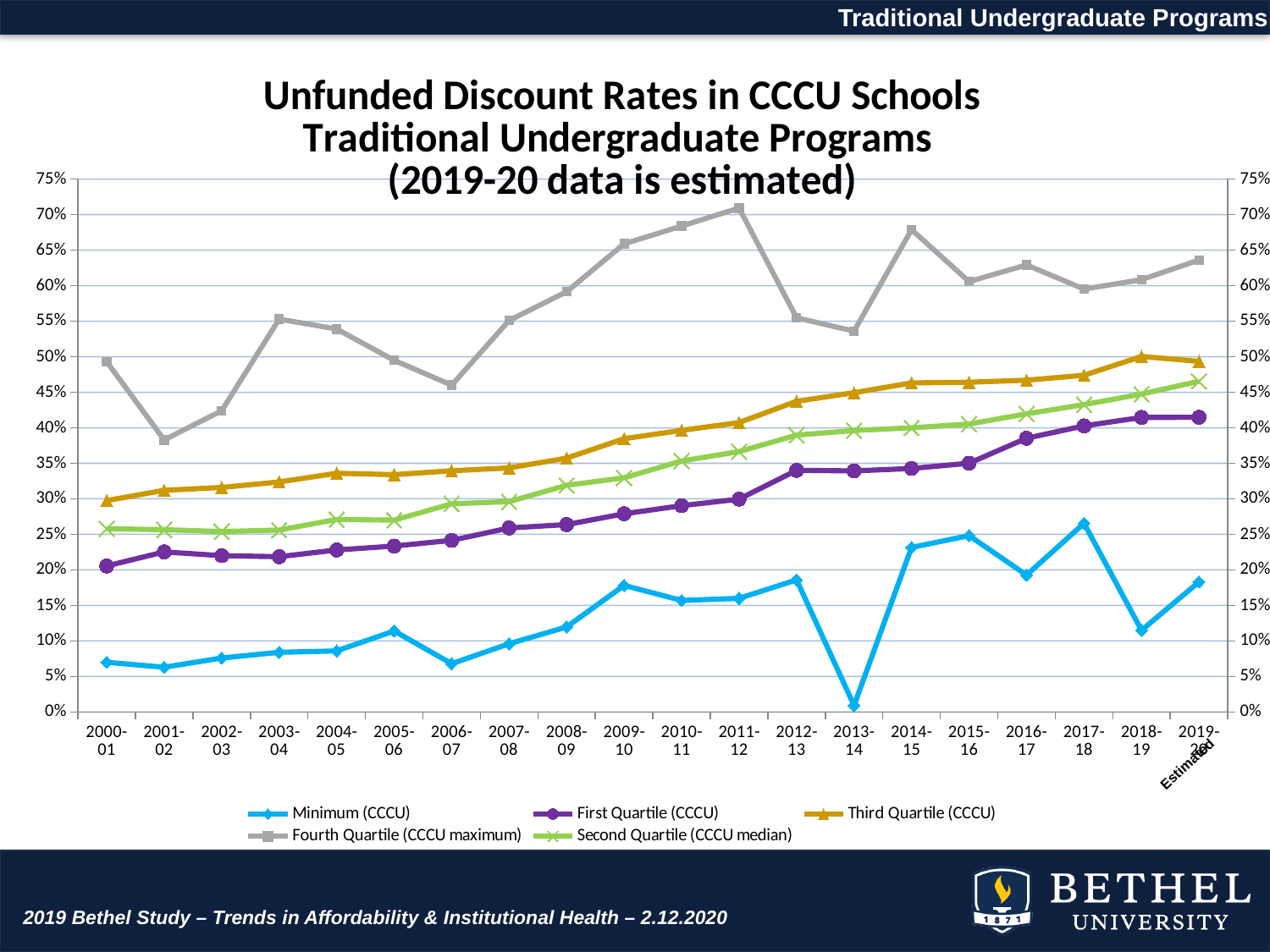
What kind of chart is shown on the slide? line chart Is the Third Quartile (CCCU) value for 2018-19 greater or less than 45%? greater Is the Fourth Quartile (CCCU maximum) value for 2011-12 greater or less than 65%? greater Is the Second Quartile (CCCU median) value for 2000-01 greater or less than 30%? less In which year does the Fourth Quartile (CCCU maximum) series reach its highest value? 2011-12 How many series does the legend list? 5 In 2014-15, which is larger: the Minimum (CCCU) value or the First Quartile (CCCU) value? First Quartile (CCCU) In which year does the Minimum (CCCU) series reach its lowest value? 2013-14 Which legend entry corresponds to the gray line with square markers? Fourth Quartile (CCCU maximum) How many academic years are plotted along the x axis? 20 Does the First Quartile (CCCU) series generally rise or fall from 2000-01 to 2019-20? rise